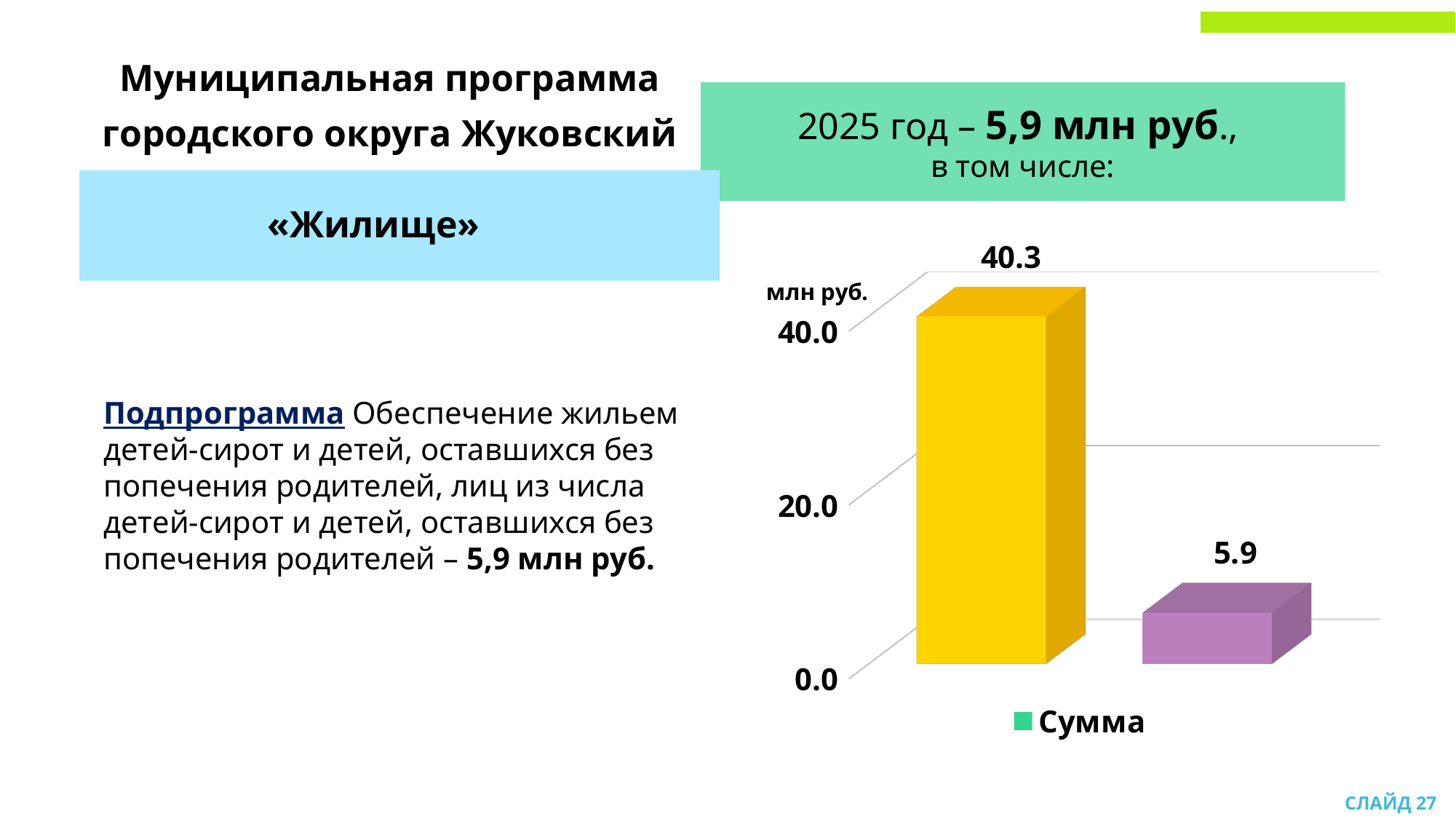
Is the value of the yellow bar greater or less than 20.0? greater What value is shown on the data label of the yellow bar? 40.3 How many bars are plotted in the chart? 2 What kind of chart is shown on the slide? bar chart What value is shown on the data label of the purple bar? 5.9 Is the value of the left bar larger or smaller than the value of the right bar? larger What unit is written next to the vertical axis of the chart? млн руб. What is the difference between the values of the yellow bar and the purple bar? 34.4 Is the value of the purple bar greater or less than 20.0? less How many series does the chart legend list? 1 Which bar has the highest value, the yellow one or the purple one? the yellow bar Which bar has the lowest value, the yellow one or the purple one? the purple bar